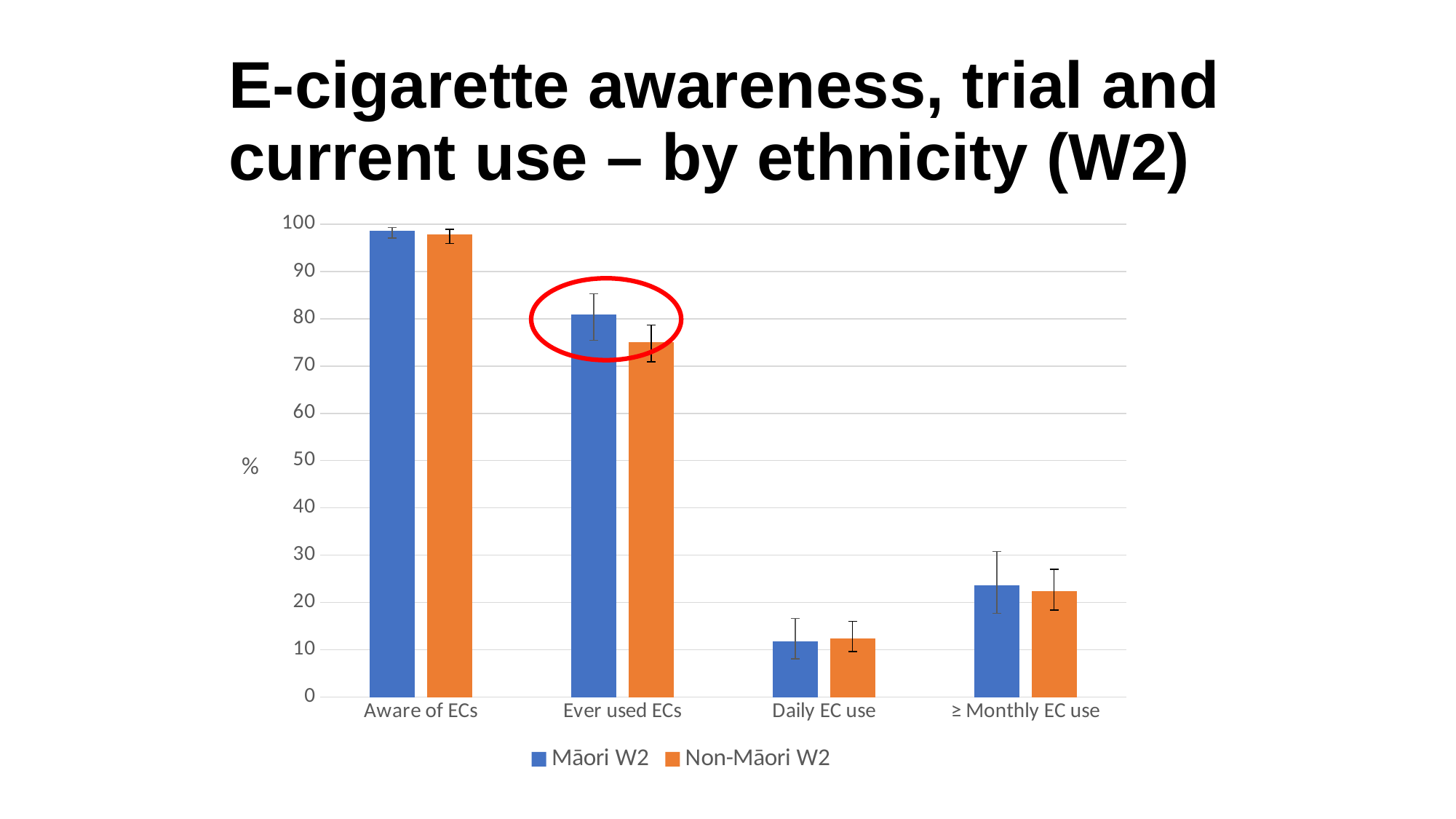
How many series does the legend list? 2 Is the Māori W2 value for Aware of ECs greater or less than 90? greater Is the Māori W2 value for Daily EC use greater or less than 20? less For Ever used ECs, which series has the larger value, Māori W2 or Non-Māori W2? Māori W2 How many categories are shown on the x axis? 4 Which category has the lowest value for Māori W2? Daily EC use Is the Māori W2 value for Ever used ECs greater or less than 70? greater What kind of chart is shown on the slide? bar chart Which category has the highest value for Māori W2? Aware of ECs Which category on the chart is circled in red? Ever used ECs Which category has the lowest value for Non-Māori W2? Daily EC use